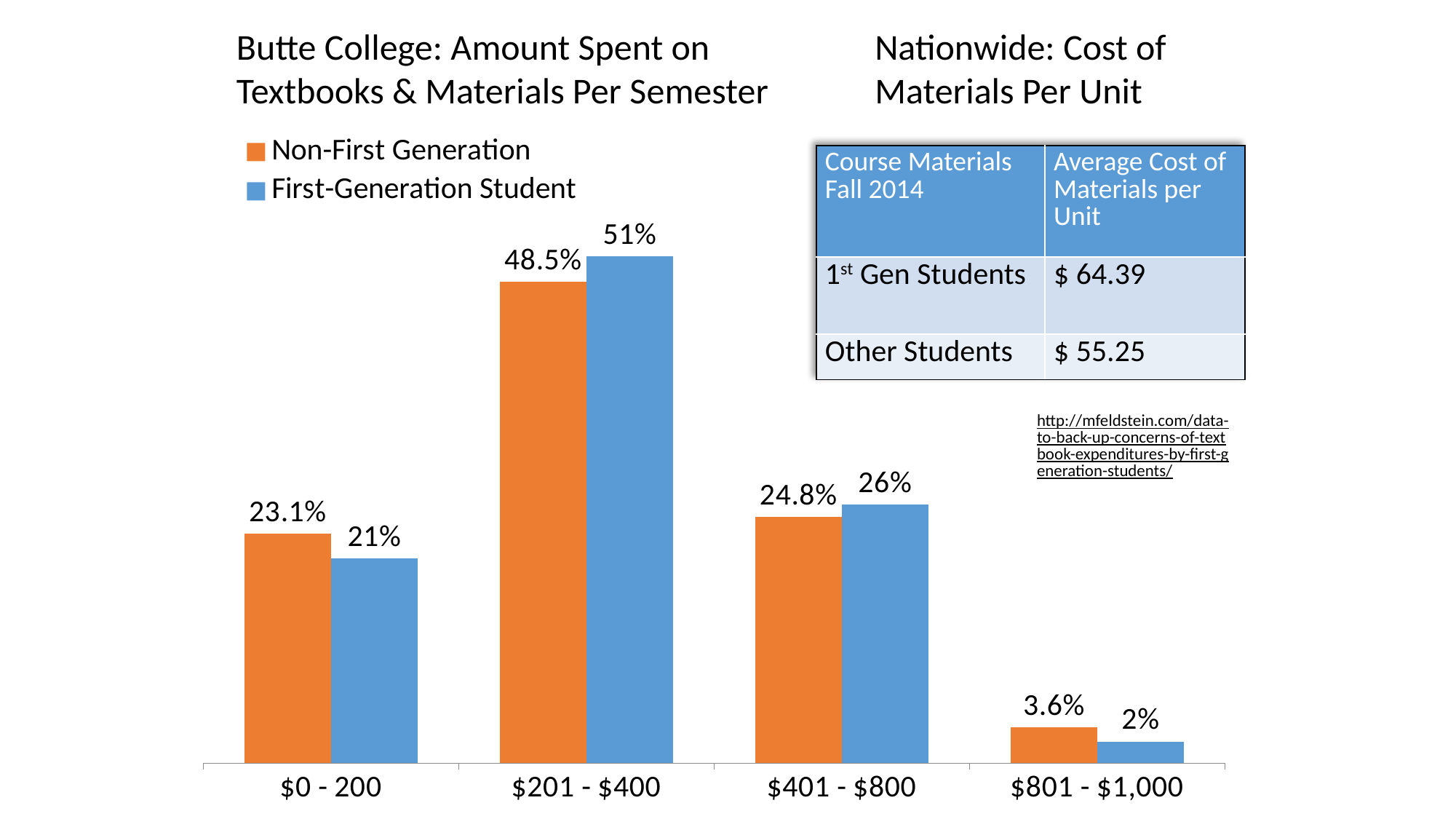
What kind of chart is shown on the slide? Bar chart In the $0 - 200 category, which series has the larger value, Non-First Generation or First-Generation Student? Non-First Generation What is the value for Non-First Generation in the $401 - $800 category? 24.8% How many categories are shown on the x axis of the chart? 4 What is the title of the chart? Butte College: Amount Spent on Textbooks & Materials Per Semester Which category has the lowest value for Non-First Generation? $801 - $1,000 What is the value for Non-First Generation in the $0 - 200 category? 23.1% What is the value for First-Generation Student in the $801 - $1,000 category? 2% What is the value for First-Generation Student in the $201 - $400 category? 51% Which category has the highest value for First-Generation Student? $201 - $400 How many series does the chart legend list? 2 What is the difference between the First-Generation Student and Non-First Generation values in the $201 - $400 category? 2.5%